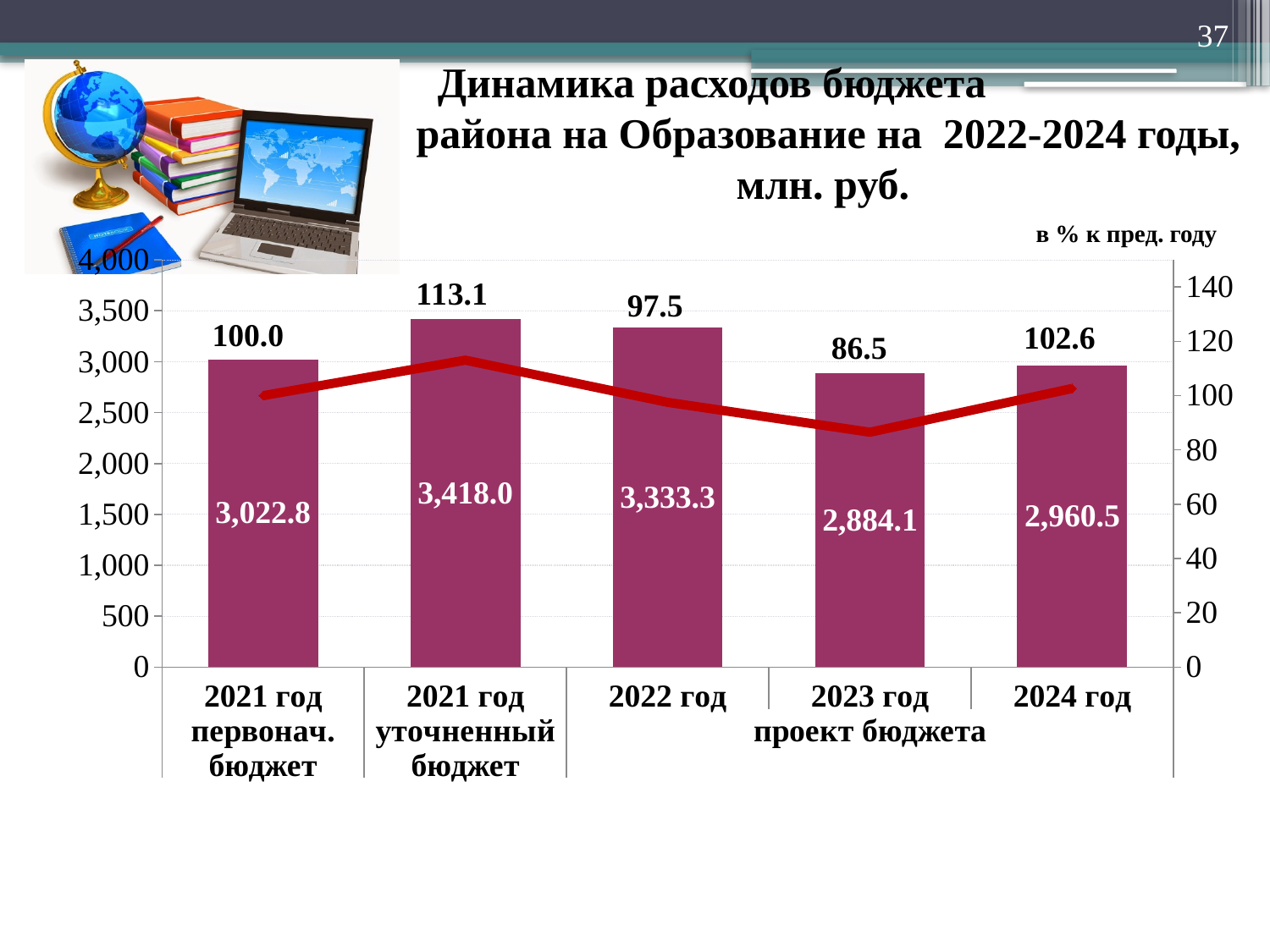
What is the bar value for 2021 год уточненный бюджет? 3,418.0 What is the difference between the % к пред. году values for 2021 год уточненный бюджет and 2023 год? 26.6 What is the value in % к пред. году shown for 2023 год? 86.5 Which category has the highest bar value? 2021 год уточненный бюджет Which category has the lowest bar value? 2023 год What is the difference between the bar values for 2021 год уточненный бюджет and 2021 год первонач. бюджет? 395.2 Which is larger, the bar value for 2024 год or for 2023 год? 2024 год How many categories are shown on the x axis? 5 What kind of chart is this? Combined bar and line chart What is the budget expenditure on education for 2022 год (проект бюджета), in млн. руб.? 3,333.3 Do the bar values rise or fall from 2022 год to 2023 год? Fall What is the label of the right-hand axis shown above the chart? в % к пред. году